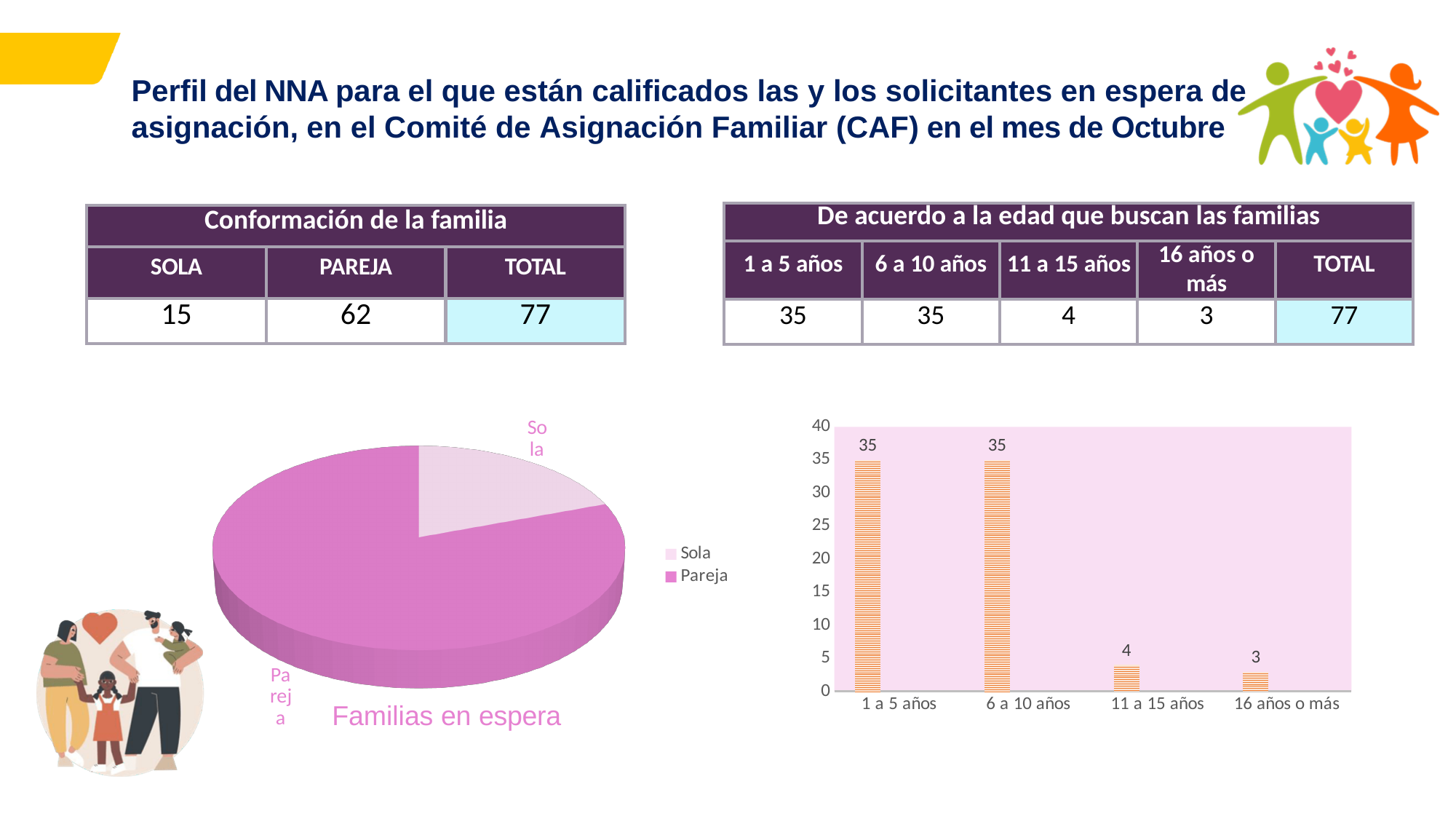
In the bar chart on the right, which is larger: the value for 11 a 15 años or the value for 16 años o más? 11 a 15 años What is the sum of all the bar values in the bar chart on the right? 77 In the bar chart on the right, what is the value for 6 a 10 años? 35 In the bar chart on the right, what is the difference between the values for 1 a 5 años and 11 a 15 años? 31 In the bar chart on the right, is the value for 1 a 5 años greater or less than 30? greater In the bar chart on the right, what is the value for 11 a 15 años? 4 What kind of chart is the 'Familias en espera' chart on the left? pie chart In the bar chart on the right, which category has the lowest value? 16 años o más How many categories are shown on the x axis of the bar chart on the right? 4 In the bar chart on the right, what is the difference between the values for 11 a 15 años and 16 años o más? 1 In the 'Familias en espera' pie chart, which slice is larger: Sola or Pareja? Pareja In the bar chart on the right, do the values rise or fall from 1 a 5 años to 16 años o más? fall